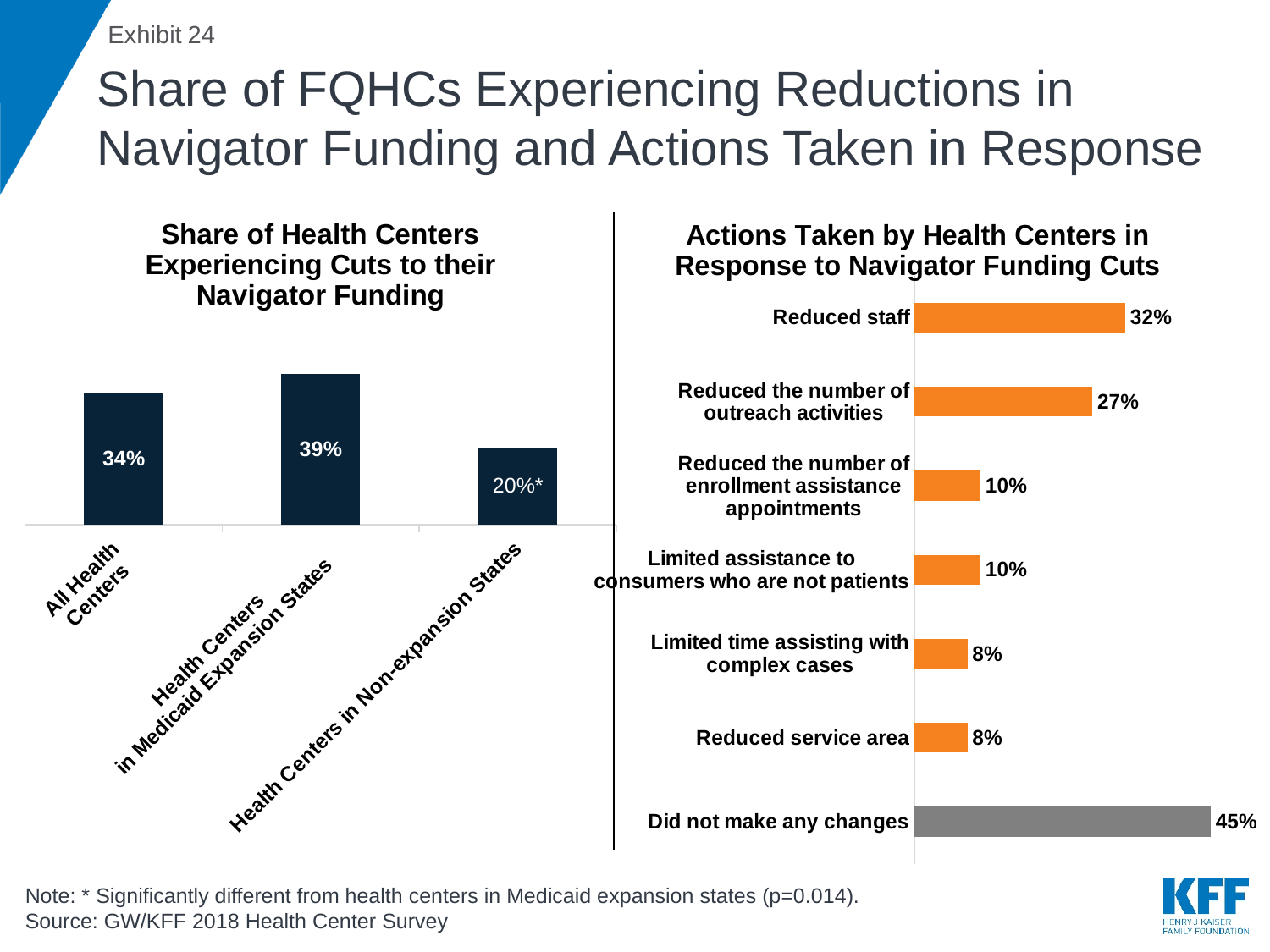
In the left chart, 'Share of Health Centers Experiencing Cuts to their Navigator Funding', how many categories are shown? 3 In the left chart, 'Share of Health Centers Experiencing Cuts to their Navigator Funding', what is the value for Health Centers in Non-expansion States? 20%* In the right chart, 'Actions Taken by Health Centers in Response to Navigator Funding Cuts', what is the value for Reduced staff? 32% In the left chart, 'Share of Health Centers Experiencing Cuts to their Navigator Funding', which category has the highest value? Health Centers in Medicaid Expansion States In the right chart, 'Actions Taken by Health Centers in Response to Navigator Funding Cuts', how many categories are shown? 7 In the right chart, 'Actions Taken by Health Centers in Response to Navigator Funding Cuts', which is larger: Reduced the number of outreach activities or Limited time assisting with complex cases? Reduced the number of outreach activities In the right chart, 'Actions Taken by Health Centers in Response to Navigator Funding Cuts', which category has the highest value? Did not make any changes What kind of chart is the right chart, 'Actions Taken by Health Centers in Response to Navigator Funding Cuts'? Bar chart In the left chart, 'Share of Health Centers Experiencing Cuts to their Navigator Funding', what is the difference between Health Centers in Medicaid Expansion States and Health Centers in Non-expansion States? 19 percentage points In the right chart, 'Actions Taken by Health Centers in Response to Navigator Funding Cuts', what is the value for Reduced the number of outreach activities? 27% In the left chart, 'Share of Health Centers Experiencing Cuts to their Navigator Funding', what is the value for All Health Centers? 34% In the right chart, 'Actions Taken by Health Centers in Response to Navigator Funding Cuts', what is the difference between Reduced staff and Reduced service area? 24 percentage points